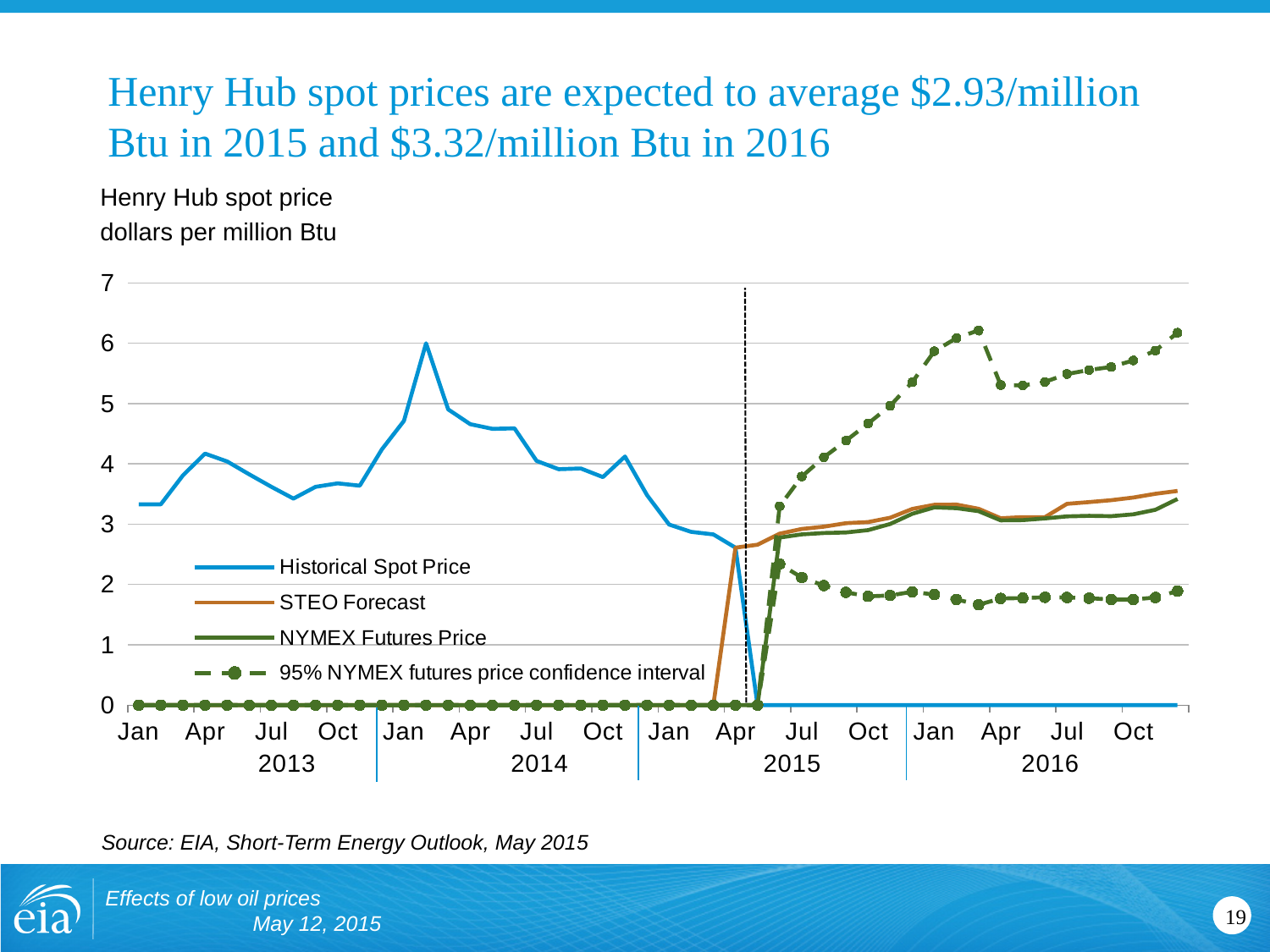
Does the Historical Spot Price rise or fall from its early 2014 peak to April 2015? fall Is the Historical Spot Price in January 2013 greater or less than 3? greater What kind of chart is shown on the slide? line chart What is the title of the chart? Henry Hub spot price Is the Historical Spot Price in April 2015 greater or less than 3? less What source is cited for the chart? EIA, Short-Term Energy Outlook, May 2015 Is the lower 95% NYMEX futures price confidence interval at the end of 2016 greater or less than 3? less In which year does the Historical Spot Price reach its highest value? 2014 How many series does the chart legend list? 4 How many years are labelled along the x axis? 4